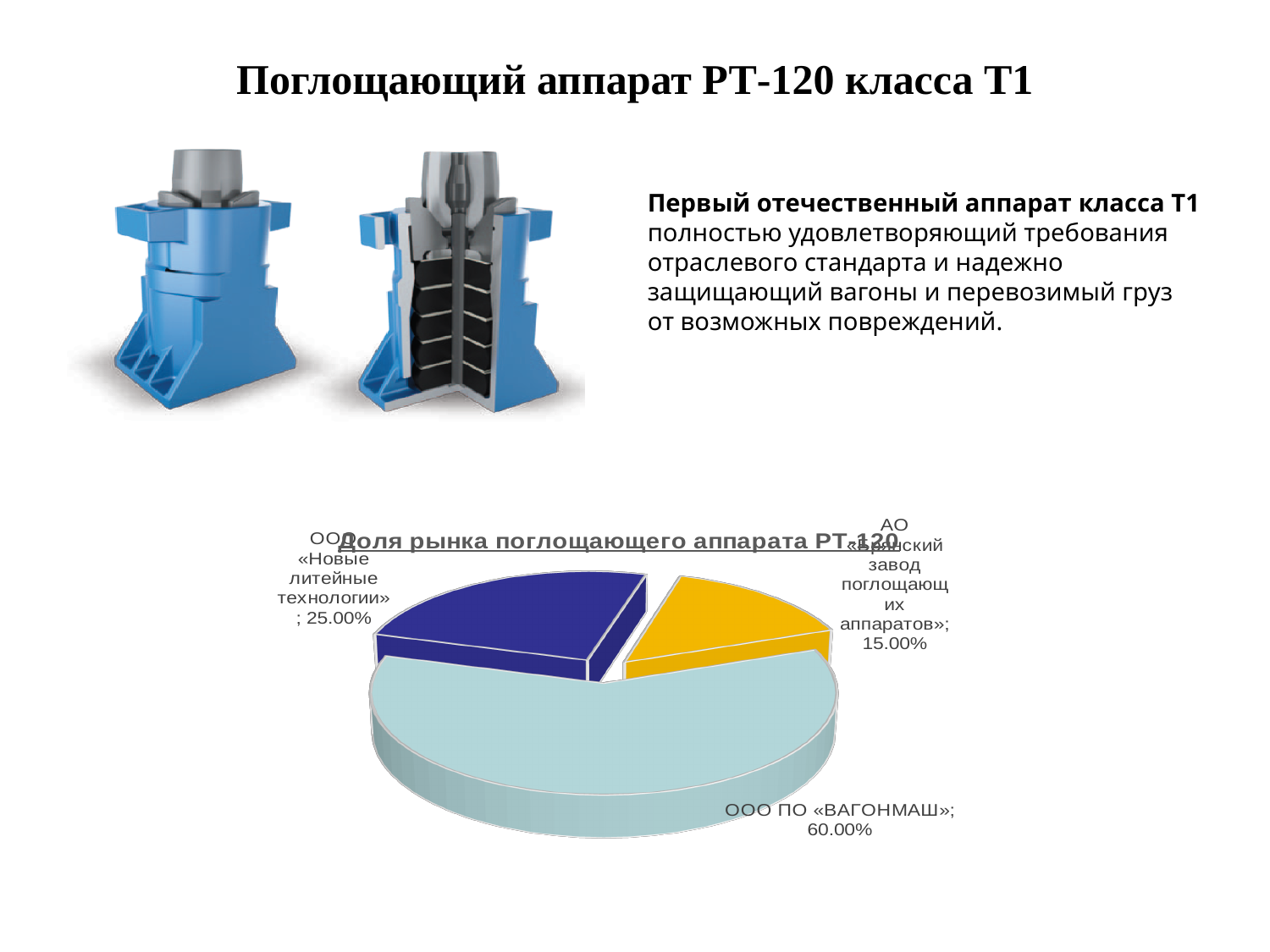
What is the title of the pie chart? Доля рынка поглощающего аппарата РТ-120 Which has a larger share: ООО «Новые литейные технологии» or АО «Брянский завод поглощающих аппаратов»? ООО «Новые литейные технологии» What is the difference between the shares of ООО «Новые литейные технологии» and АО «Брянский завод поглощающих аппаратов»? 10.00% What share of the market does ООО «Новые литейные технологии» hold according to the pie chart? 25.00% How many slices does the pie chart have? 3 Which company has the largest share in the pie chart? ООО ПО «ВАГОНМАШ» What share of the market does ООО ПО «ВАГОНМАШ» hold according to the pie chart? 60.00% What kind of chart is shown on the slide? pie chart What share of the market does АО «Брянский завод поглощающих аппаратов» hold according to the pie chart? 15.00% What colour is the slice for ООО ПО «ВАГОНМАШ» in the pie chart? light blue Which company has the smallest share in the pie chart? АО «Брянский завод поглощающих аппаратов» What is the difference between the shares of ООО ПО «ВАГОНМАШ» and ООО «Новые литейные технологии»? 35.00%